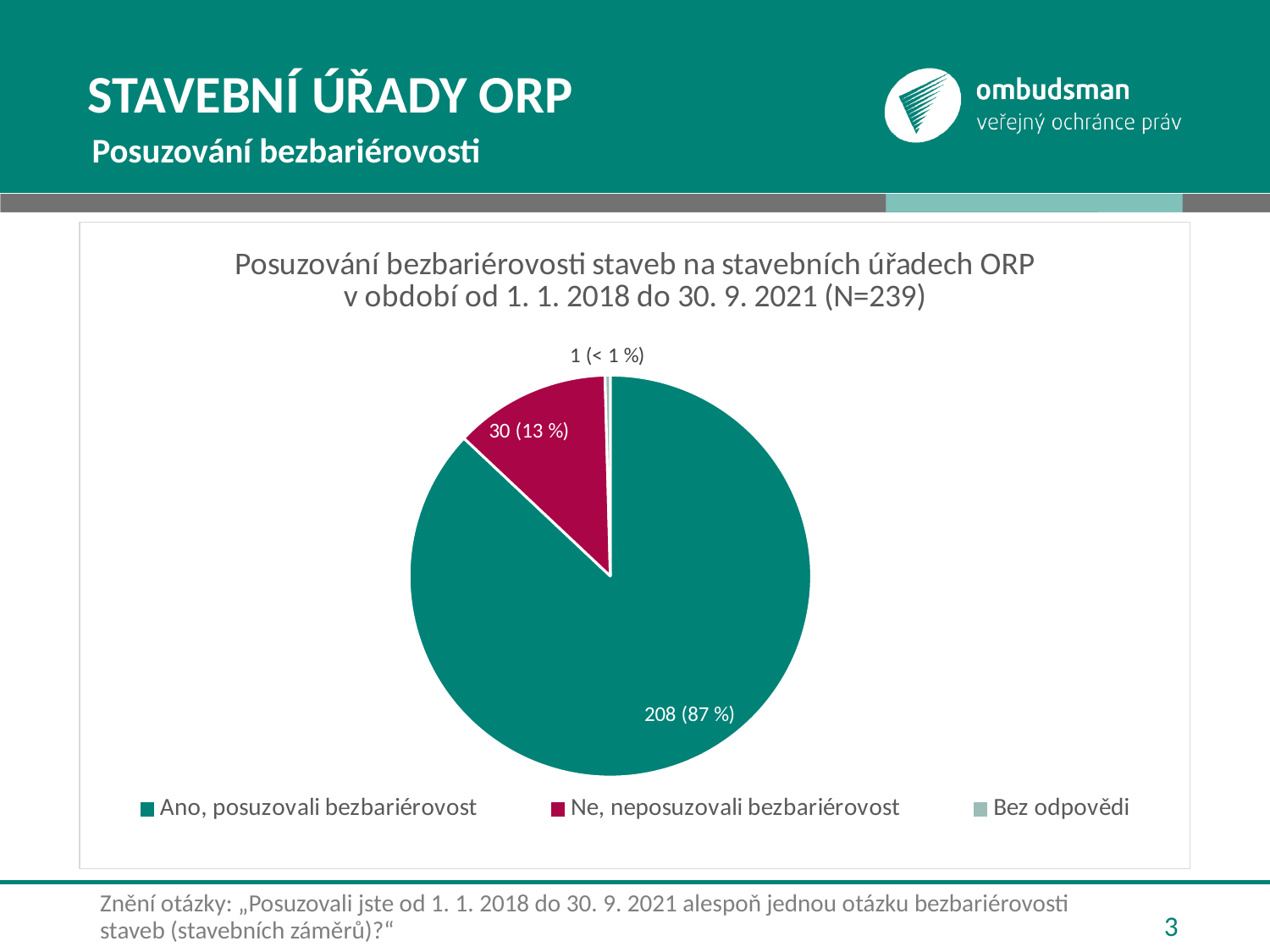
Which category has the smallest slice of the pie? Bez odpovědi What is the N value stated in the chart title? N=239 Which category has the largest slice of the pie? Ano, posuzovali bezbariérovost How many slices does the pie chart have? 3 What is the difference in count between "Ano, posuzovali bezbariérovost" and "Ne, neposuzovali bezbariérovost"? 178 What is the value shown for "Ne, neposuzovali bezbariérovost"? 30 (13 %) What kind of chart is shown on the slide? pie chart What share of the pie does "Ne, neposuzovali bezbariérovost" represent? 13 % How many entries does the legend of the pie chart list? 3 What is the value shown for "Ano, posuzovali bezbariérovost"? 208 (87 %) Which is larger: the count for "Ne, neposuzovali bezbariérovost" or for "Bez odpovědi"? Ne, neposuzovali bezbariérovost What is the value shown for "Bez odpovědi"? 1 (< 1 %)